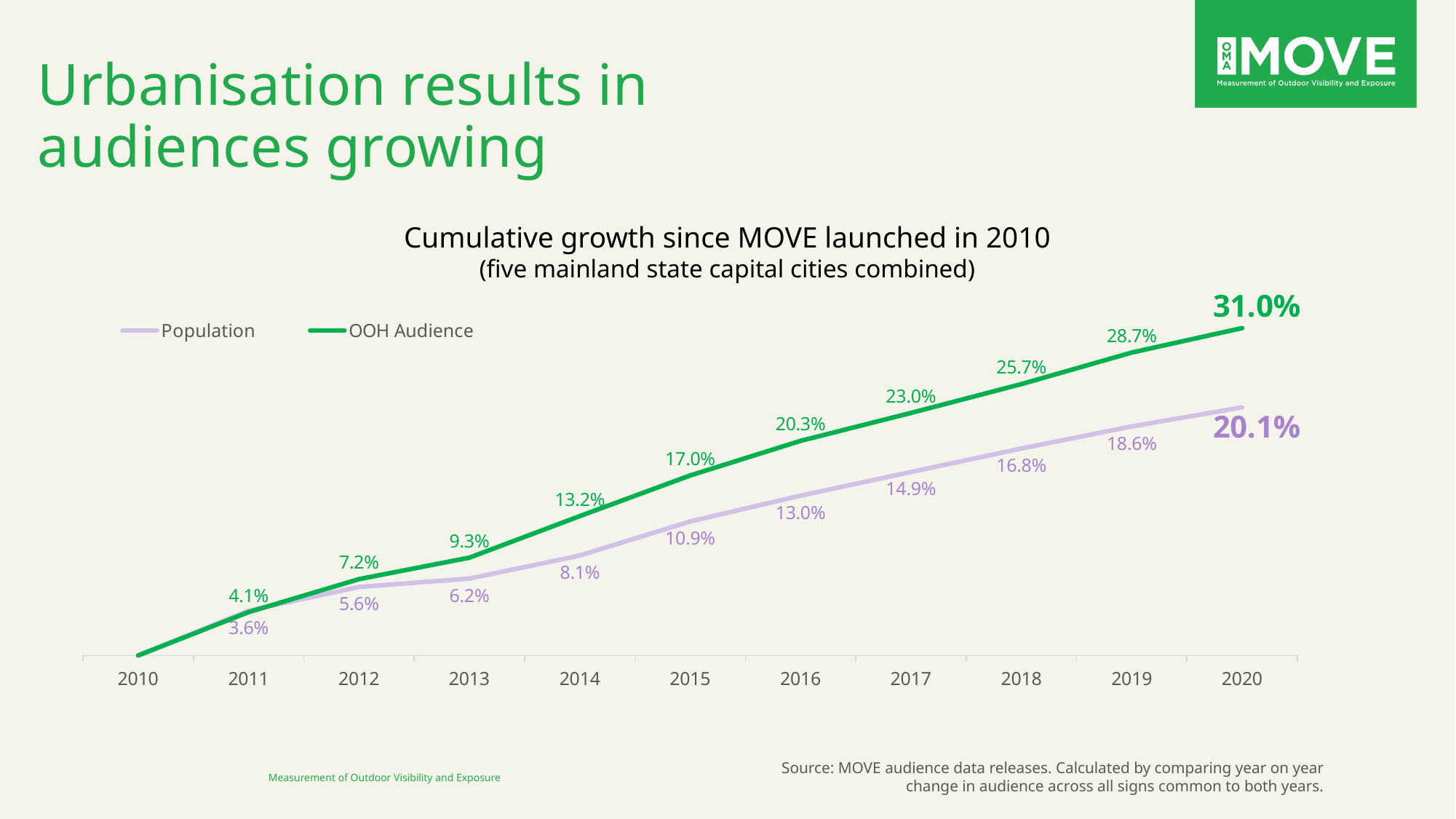
Do the OOH Audience values rise or fall from 2010 to 2020? Rise What is the Population value for 2011? 3.6% What is the title of the chart? Cumulative growth since MOVE launched in 2010 How many series does the legend list? 2 What kind of chart is shown on the slide? Line chart Which is larger in 2018, the OOH Audience value or the Population value? OOH Audience What is the Population cumulative growth value for 2016? 13.0% What is the OOH Audience value for 2014? 13.2% What is the difference between the OOH Audience and Population values in 2020? 10.9% How many years are shown on the x axis? 11 In which year does the OOH Audience series reach its highest value? 2020 What is the OOH Audience cumulative growth value for 2020? 31.0%